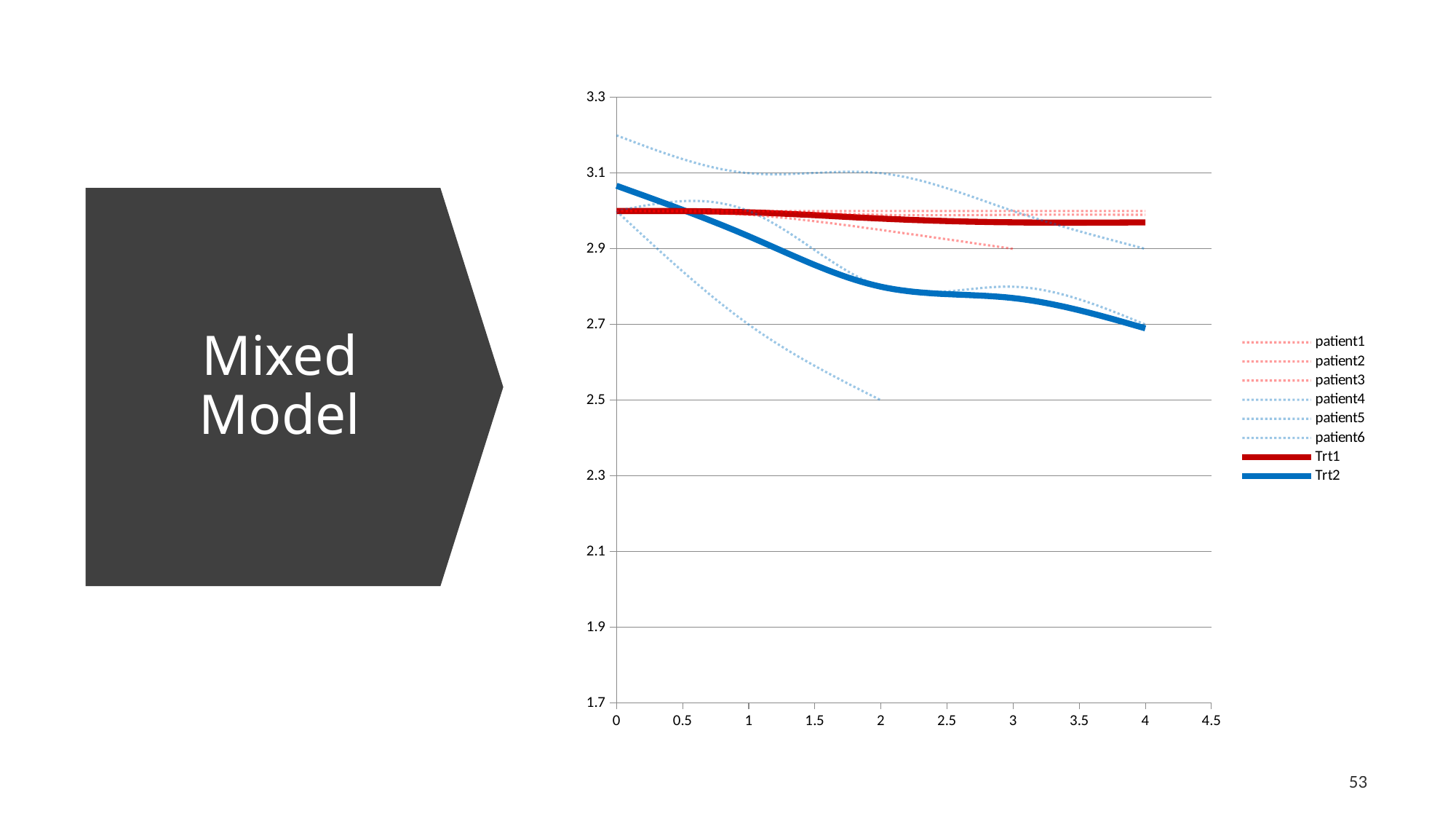
At x = 3, which is larger, Trt1 or Trt2? Trt1 Is the value for Trt1 at x = 4 greater or less than 2.9? greater Is the value for patient6 at x = 1 greater or less than 2.9? less Is the value for patient4 at x = 0 greater or less than 3.1? greater At x = 4, which is larger, Trt1 or Trt2? Trt1 Which series has the highest value at x = 0? patient4 How many series does the legend list? 8 What kind of chart is shown on the slide? line chart How many patient series are listed in the legend? 6 Does the Trt2 line rise or fall as x increases from 0 to 4? falls What colour is the Trt2 line? blue